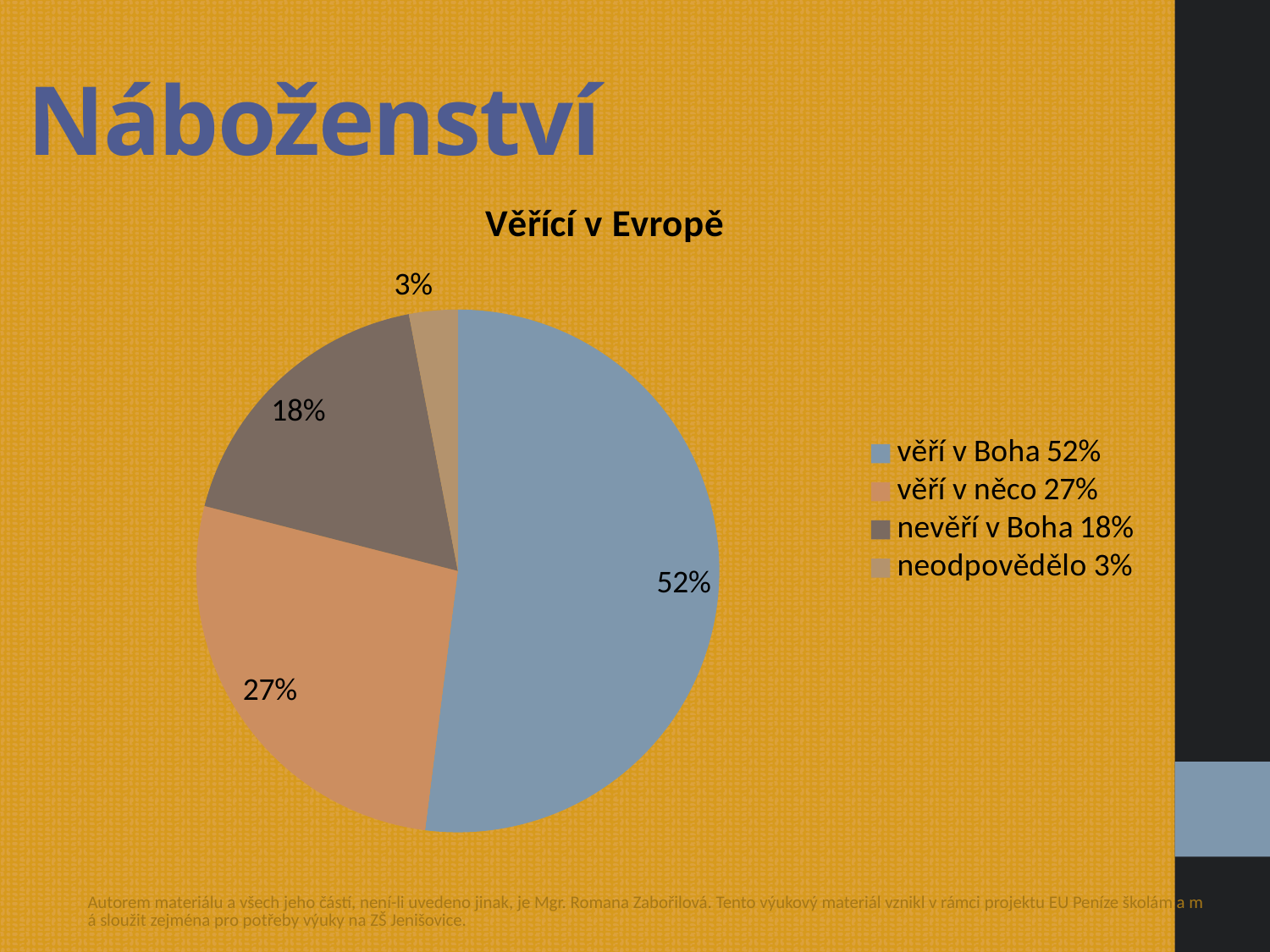
Which category has the largest slice? věří v Boha What is the difference between 'věří v Boha' and 'věří v něco'? 25% How many categories does the pie chart have? 4 What is the value for 'neodpovědělo'? 3% What share of the pie does 'věří v Boha' take? 52% What is the value for 'nevěří v Boha'? 18% Which is larger, 'věří v něco' or 'nevěří v Boha'? věří v něco Which category has the smallest slice? neodpovědělo What is the value for 'věří v něco'? 27% What is the combined share of 'nevěří v Boha' and 'neodpovědělo'? 21% What is the title of the chart? Věřící v Evropě What kind of chart is shown on the slide? pie chart